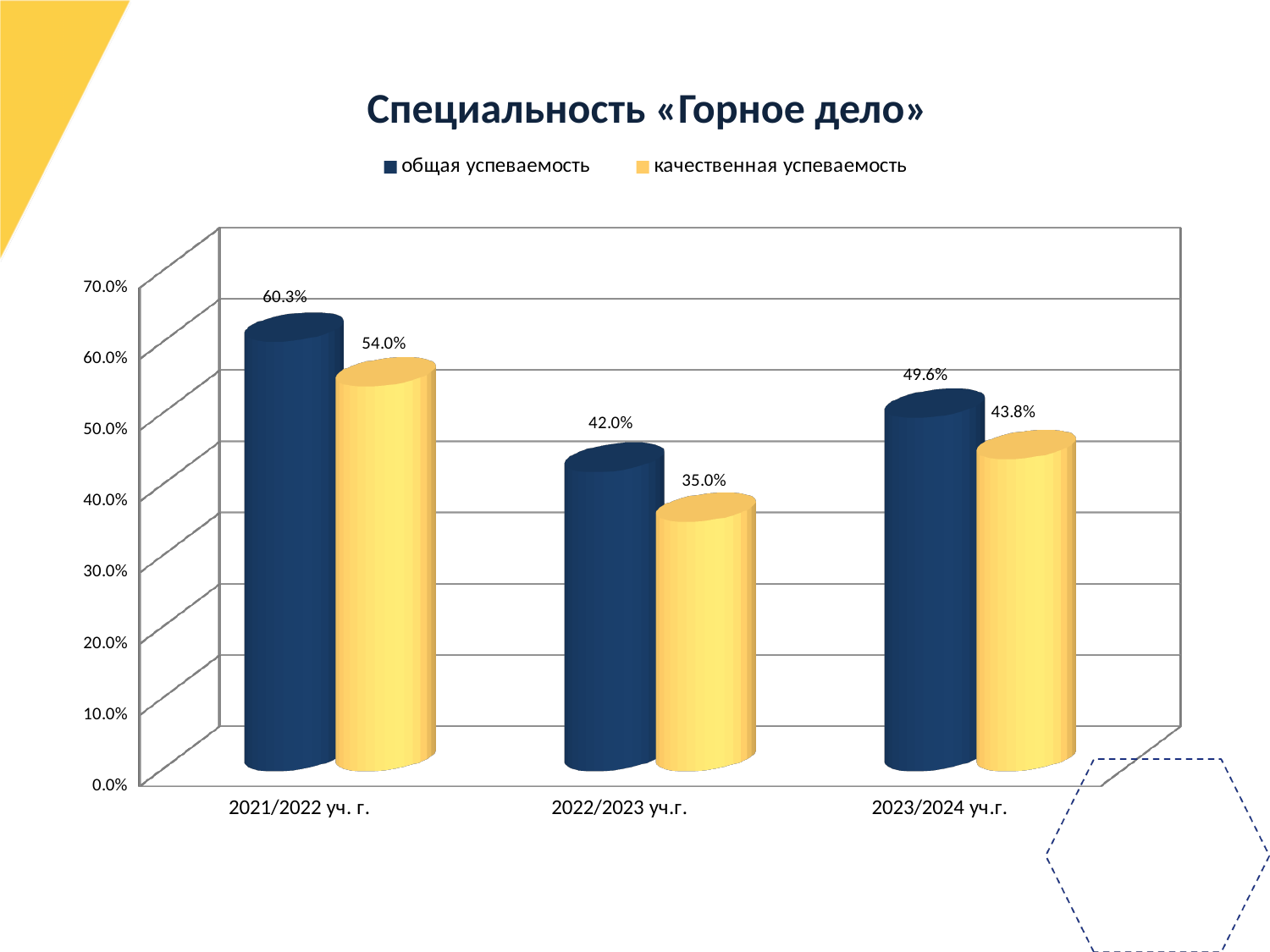
What is the value of качественная успеваемость for 2023/2024 уч.г.? 43.8% Which academic year has the lowest качественная успеваемость? 2022/2023 уч.г. How many series does the legend list? 2 What kind of chart is shown on the slide? bar chart What is the value of качественная успеваемость for 2022/2023 уч.г.? 35.0% What is the difference between общая успеваемость and качественная успеваемость in 2022/2023 уч.г.? 7.0% What is the value of общая успеваемость for 2021/2022 уч. г.? 60.3% Is the value of качественная успеваемость for 2021/2022 уч. г. greater or less than 50.0%? greater How many academic years are shown on the x axis? 3 Which academic year has the highest общая успеваемость? 2021/2022 уч. г. Which is larger: общая успеваемость in 2023/2024 уч.г. or общая успеваемость in 2022/2023 уч.г.? общая успеваемость in 2023/2024 уч.г. What is the title of the chart? Специальность «Горное дело»